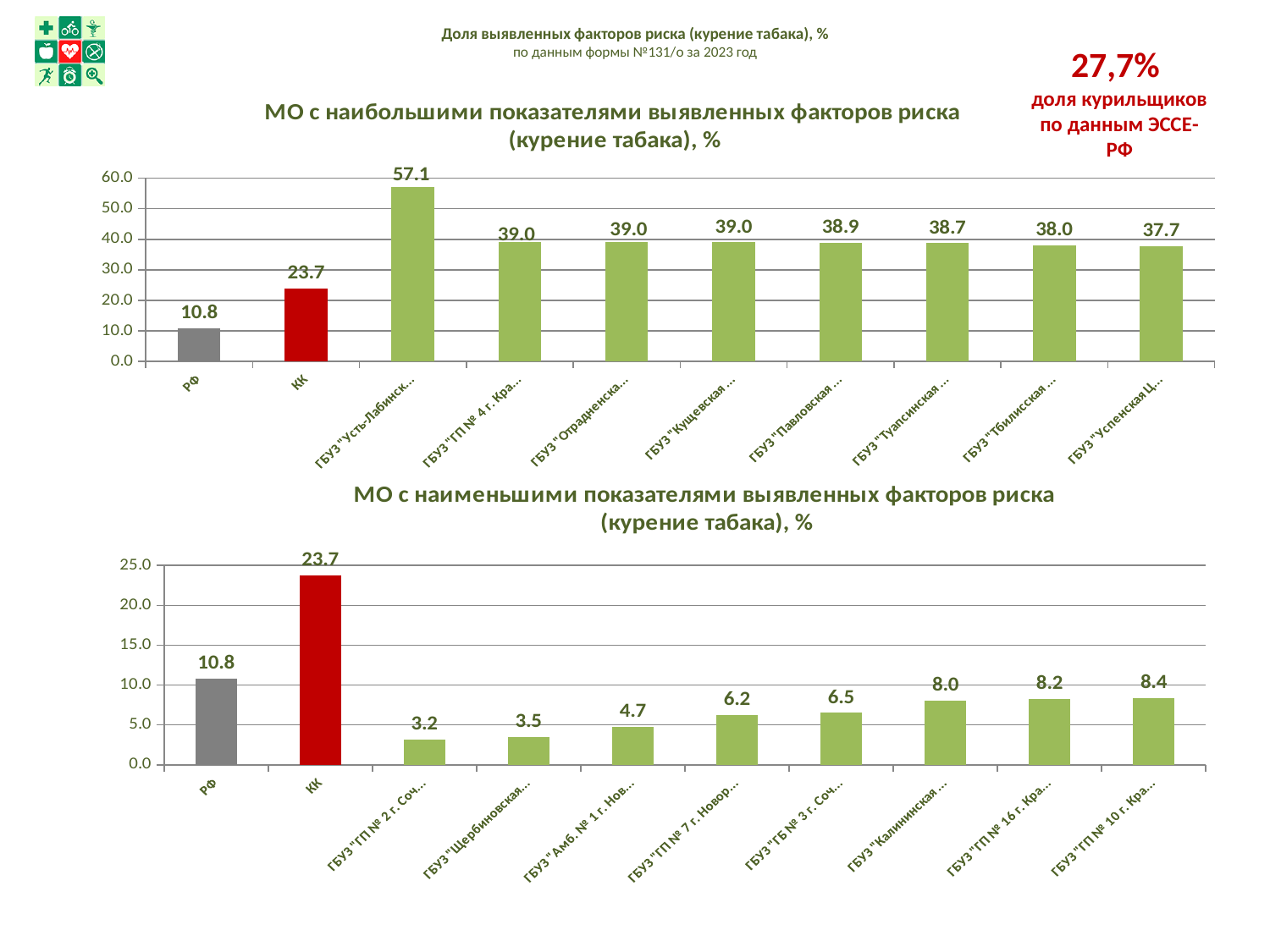
In the top chart (МО с наибольшими показателями), what is the difference between the value for ГБУЗ "Усть-Лабинск... and the value for КК? 33.4 In the bottom chart (МО с наименьшими показателями), which is larger: the value for РФ or the value for ГБУЗ "ГП № 10 г. Кра...? РФ In the top chart (МО с наибольшими показателями), what is the value for КК? 23.7 In the top chart (МО с наибольшими показателями), what is the value for РФ? 10.8 In the bottom chart (МО с наименьшими показателями), what is the difference between the value for КК and the value for РФ? 12.9 In the top chart (МО с наибольшими показателями), what is the value for ГБУЗ "Павловская ...? 38.9 In the bottom chart (МО с наименьшими показателями), what is the value for ГБУЗ "Калининская ...? 8.0 What type of chart is the bottom chart (МО с наименьшими показателями)? bar chart In the top chart (МО с наибольшими показателями), how many bars are plotted? 10 In the bottom chart (МО с наименьшими показателями), what is the value for ГБУЗ "ГП № 2 г. Соч...? 3.2 In the bottom chart (МО с наименьшими показателями), which category has the lowest value? ГБУЗ "ГП № 2 г. Соч... In the top chart (МО с наибольшими показателями), which category has the highest value? ГБУЗ "Усть-Лабинск...